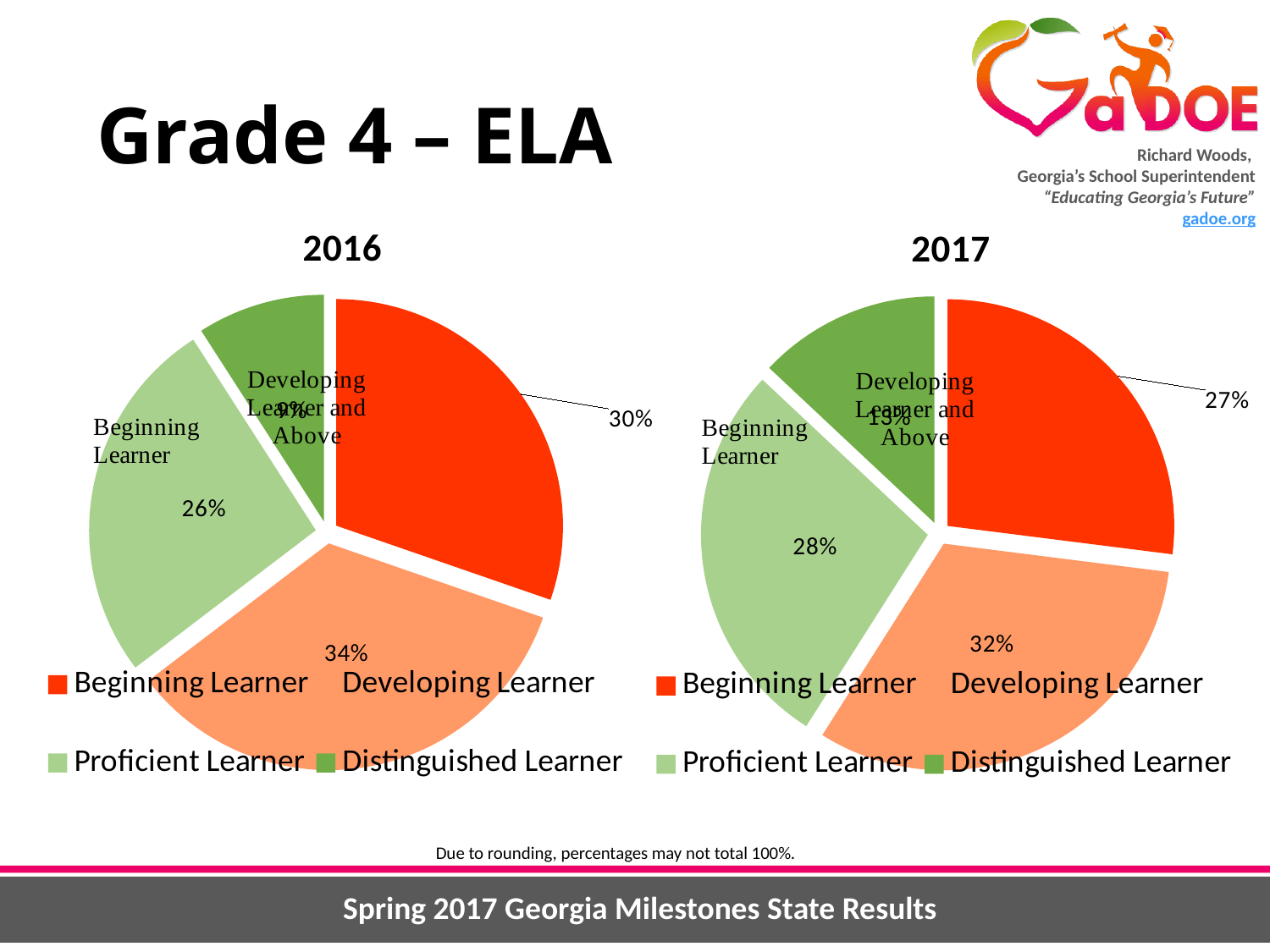
In the 2017 pie chart, what percentage is shown for Beginning Learner? 27% In the 2016 pie chart, what percentage is shown for Beginning Learner? 30% In the 2016 pie chart, how many percentage points larger is Developing Learner than Proficient Learner? 8 percentage points In the 2016 pie chart, what percentage is shown for Developing Learner? 34% Comparing the two charts, by how many percentage points did the Beginning Learner share fall from 2016 to 2017? 3 percentage points In the 2016 pie chart, which category has the largest slice? Developing Learner In the 2016 pie chart, what percentage is shown for Proficient Learner? 26% In the 2016 pie chart, which category has the smallest slice? Distinguished Learner In the 2017 pie chart, what percentage is shown for Developing Learner? 32% What type of chart is used for the 2016 and 2017 results on this slide? Pie chart In the 2017 pie chart, what percentage is shown for Proficient Learner? 28% In the 2017 pie chart, which category has the largest slice? Developing Learner